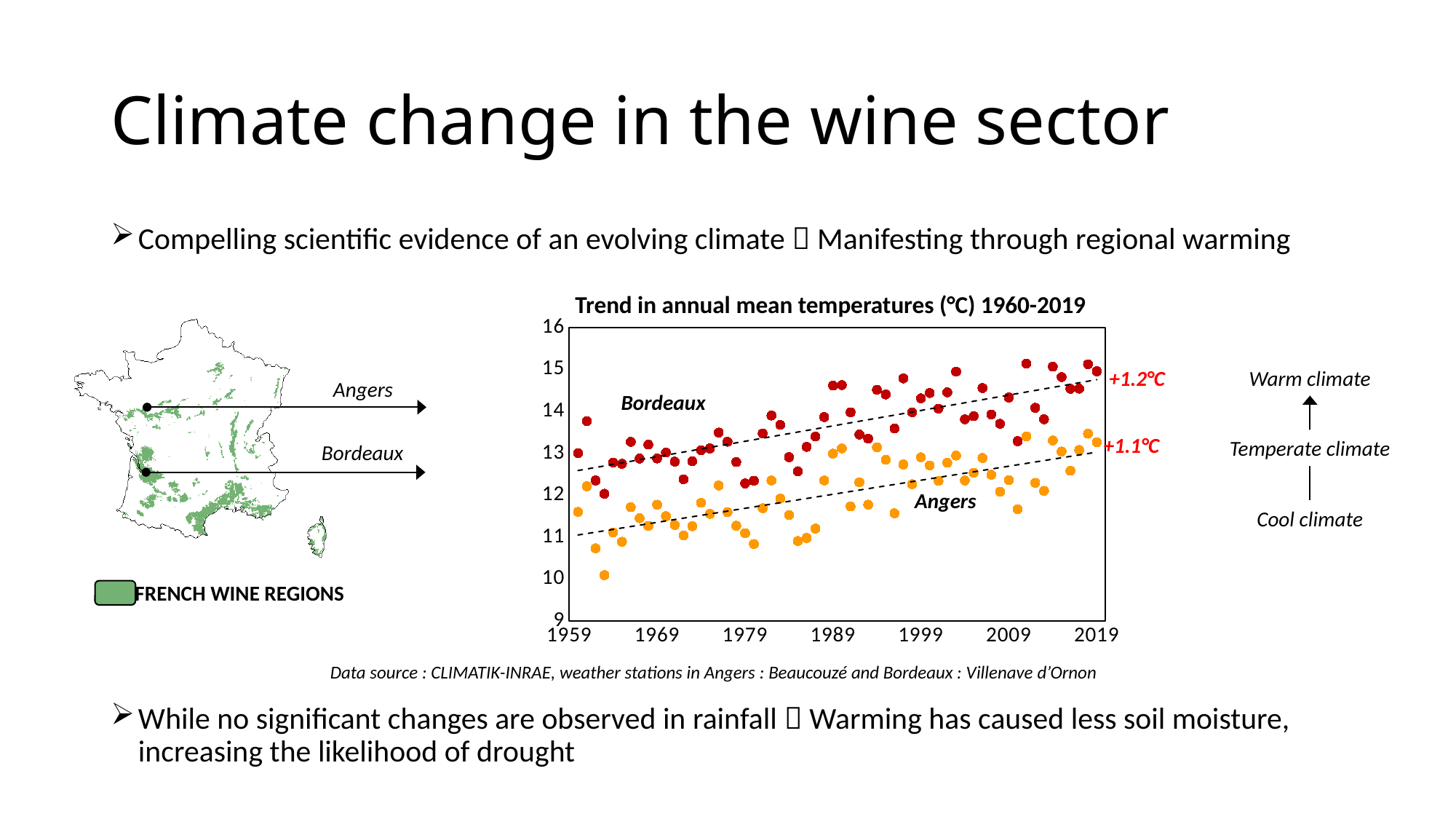
Which two locations are plotted on the chart? Bordeaux and Angers What temperature increase is annotated for the Angers trend line? +1.1°C What kind of chart is shown on the slide? scatter chart Is the lowest plotted value for Angers greater or less than 11? less What is the title of the chart? Trend in annual mean temperatures (°C) 1960-2019 Which series generally has higher annual mean temperatures, Bordeaux or Angers? Bordeaux Do the annual mean temperatures for Bordeaux rise or fall from 1959 to 2019? rise Do the annual mean temperatures for Angers rise or fall from 1959 to 2019? rise Is the highest plotted value for Bordeaux greater or less than 14? greater How many series are plotted on the chart? 2 Is the highest plotted value for Angers greater or less than 14? less What temperature increase is annotated for the Bordeaux trend line? +1.2°C